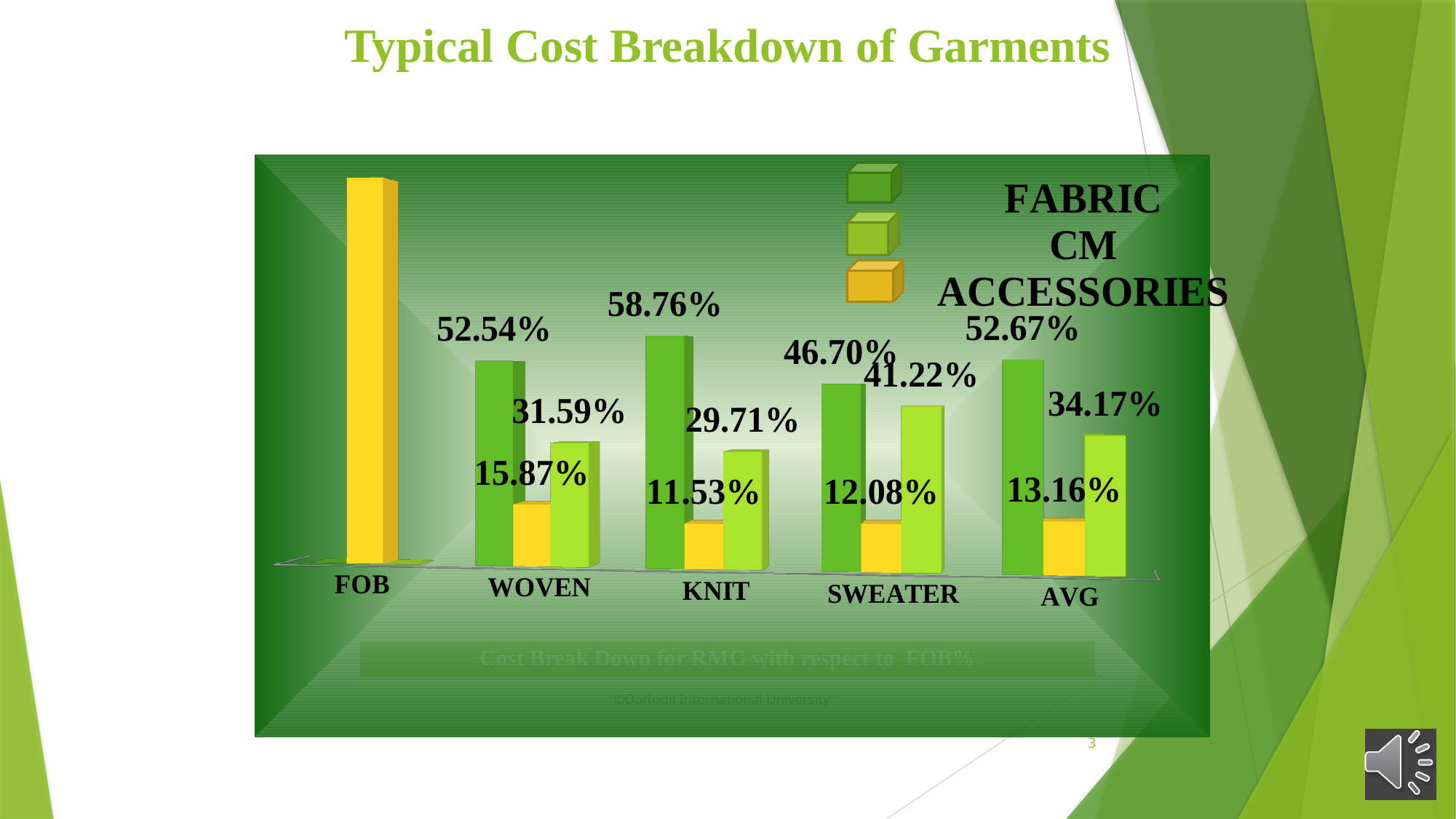
What is the ACCESSORIES value for WOVEN? 15.87% What is the FABRIC value for KNIT? 58.76% Which category has the lowest ACCESSORIES value among WOVEN, KNIT, SWEATER and AVG? KNIT What is the title of the slide? Typical Cost Breakdown of Garments What is the difference between the FABRIC value for KNIT and the FABRIC value for SWEATER? 12.06% Which is larger for SWEATER, the FABRIC value or the CM value? FABRIC What is the CM value for SWEATER? 41.22% How many series does the legend list? 3 Which category has the highest FABRIC value? KNIT How many categories are shown on the x axis? 5 What kind of chart is shown on the slide? Bar chart What is the FABRIC value for AVG? 52.67%